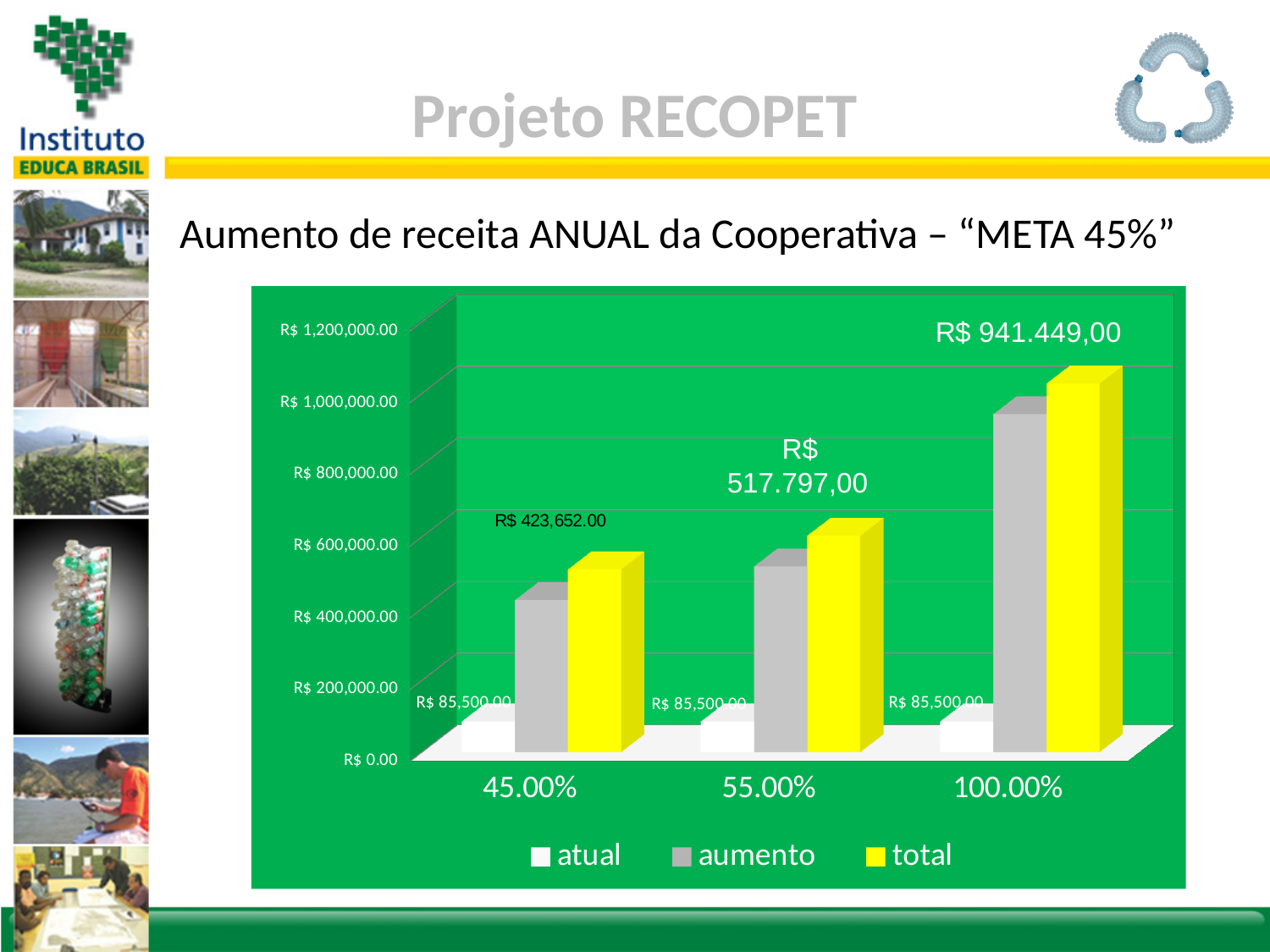
Do the 'total' values rise or fall from 45.00% to 100.00% along the x axis? rise Which category has the highest 'total' bar? 100.00% What are the series names listed in the chart legend? atual, aumento, total Is the 'total' value for 100.00% greater or less than R$ 800,000.00? greater How many categories are shown on the x axis of the chart? 3 What kind of chart is shown on the slide? bar chart Which category has the lowest 'aumento' bar? 45.00% How many series does the chart legend list? 3 Is the 'aumento' value for 45.00% greater or less than R$ 600,000.00? less What is the value of the 'atual' series for the 45.00% category? R$ 85,500.00 What is the value of the 'atual' series for the 100.00% category? R$ 85,500.00 Which is larger: the 'total' bar for 55.00% or the 'total' bar for 100.00%? 100.00%